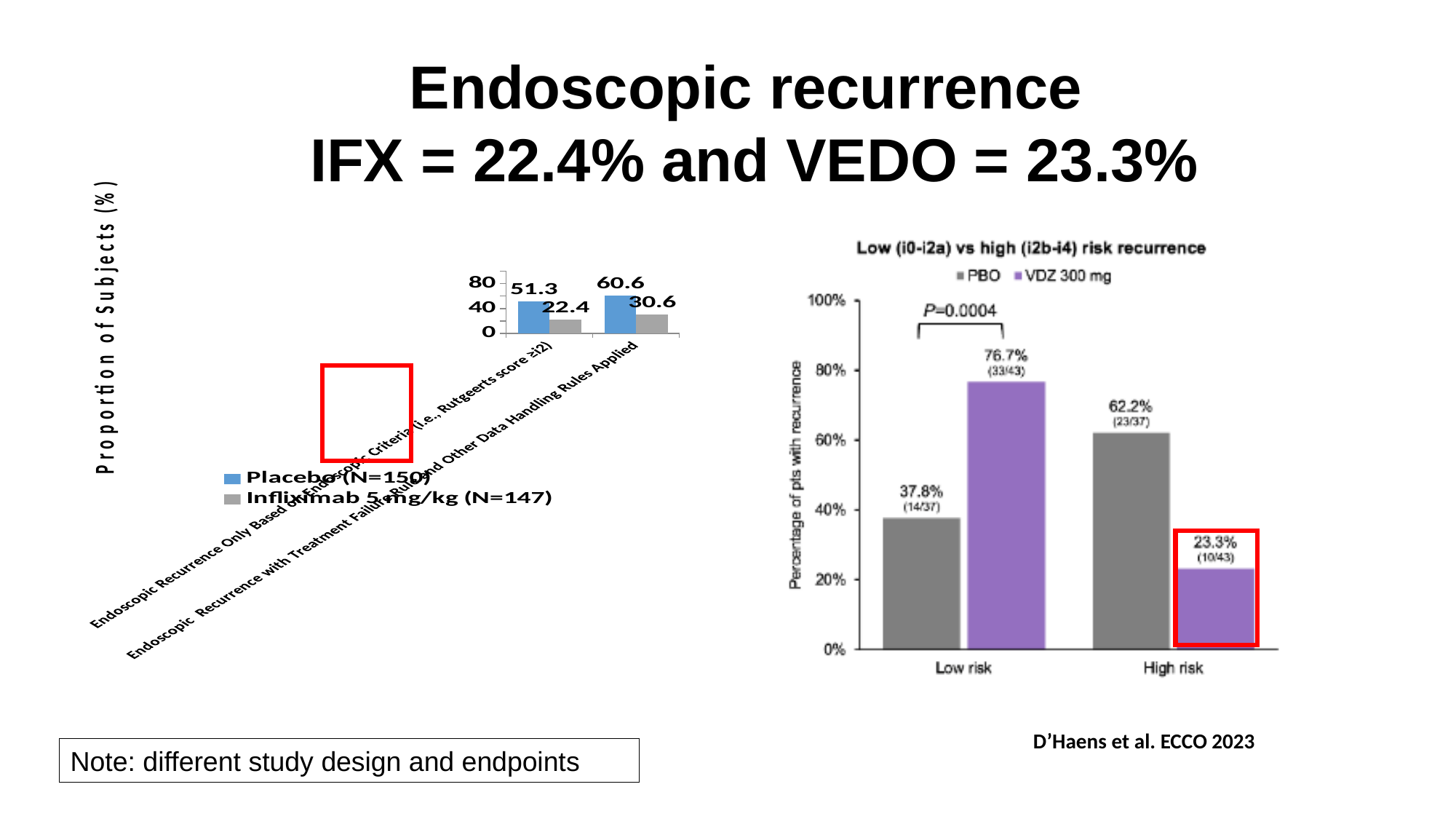
In the chart titled 'Low (i0-i2a) vs high (i2b-i4) risk recurrence', what P value is shown for the Low risk comparison? P=0.0004 In the left chart with Placebo and Infliximab, what is the value for Infliximab 5 mg/kg in the first category (Endoscopic Recurrence Only Based on Endoscopic Criteria)? 22.4 In the chart titled 'Low (i0-i2a) vs high (i2b-i4) risk recurrence', what is the value for VDZ 300 mg in the High risk group? 23.3% What type of chart is the left chart with Placebo and Infliximab? Bar chart In the chart titled 'Low (i0-i2a) vs high (i2b-i4) risk recurrence', what is the value for PBO in the Low risk group? 37.8% In the chart titled 'Low (i0-i2a) vs high (i2b-i4) risk recurrence', which is larger in the Low risk group, PBO or VDZ 300 mg? VDZ 300 mg In the left chart with Placebo and Infliximab, which series has the higher values in both categories? Placebo (N=150) In the left chart with Placebo and Infliximab, what is the difference between Placebo and Infliximab 5 mg/kg in the second category? 30.0 In the chart titled 'Low (i0-i2a) vs high (i2b-i4) risk recurrence', how many series does the legend list? 2 In the chart titled 'Low (i0-i2a) vs high (i2b-i4) risk recurrence', which bar is the highest? VDZ 300 mg, Low risk (76.7%) In the left chart with Placebo and Infliximab, what is the value for Placebo in the second category (Endoscopic Recurrence with Treatment Failure Rule and Other Data Handling Rules Applied)? 60.6 In the chart titled 'Low (i0-i2a) vs high (i2b-i4) risk recurrence', what is the difference between PBO and VDZ 300 mg in the High risk group? 38.9%